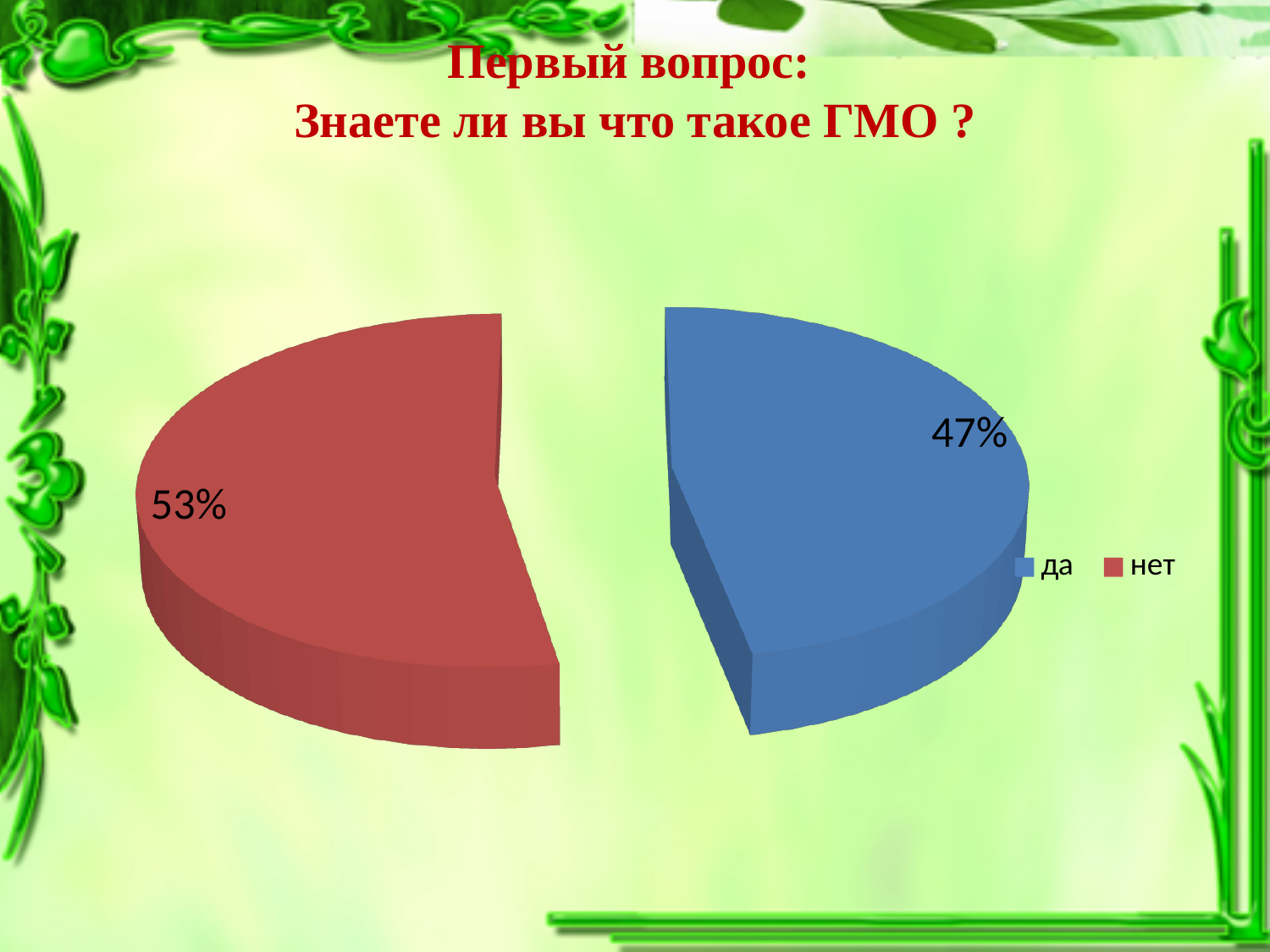
What percentage is shown for the "да" slice? 47% How many slices does the pie chart have? 2 What percentage is shown for the "нет" slice? 53% Which is larger, the "да" slice or the "нет" slice? нет What kind of chart is shown on the slide? pie chart What colour is the "нет" slice? red Which slice is the smallest? да How many entries does the legend list? 2 What is the difference between the "нет" and "да" percentages? 6% Which slice is the largest? нет What colour is the "да" slice? blue